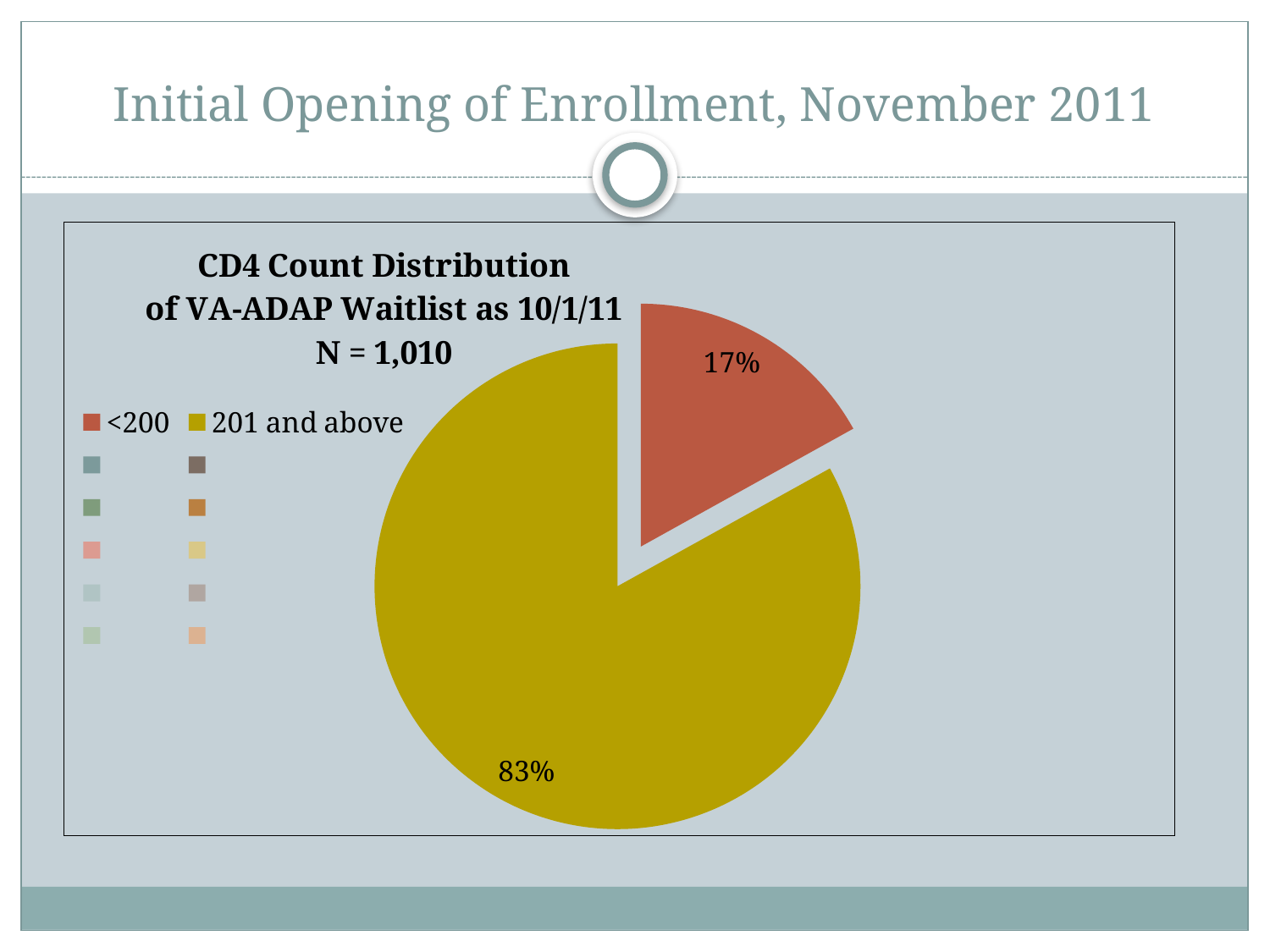
Which is larger, the <200 slice or the 201 and above slice? 201 and above Which slice of the pie is the largest? 201 and above What colour is the <200 slice of the pie? red How many labeled slices does the pie chart have? 2 Which slice of the pie is the smallest? <200 What is the N value stated in the chart title? 1,010 What percentage of the pie is the <200 slice? 17% What percentage of the pie is the 201 and above slice? 83% What is the difference in percentage points between the 201 and above slice and the <200 slice? 66 What type of chart is shown on the slide? pie chart